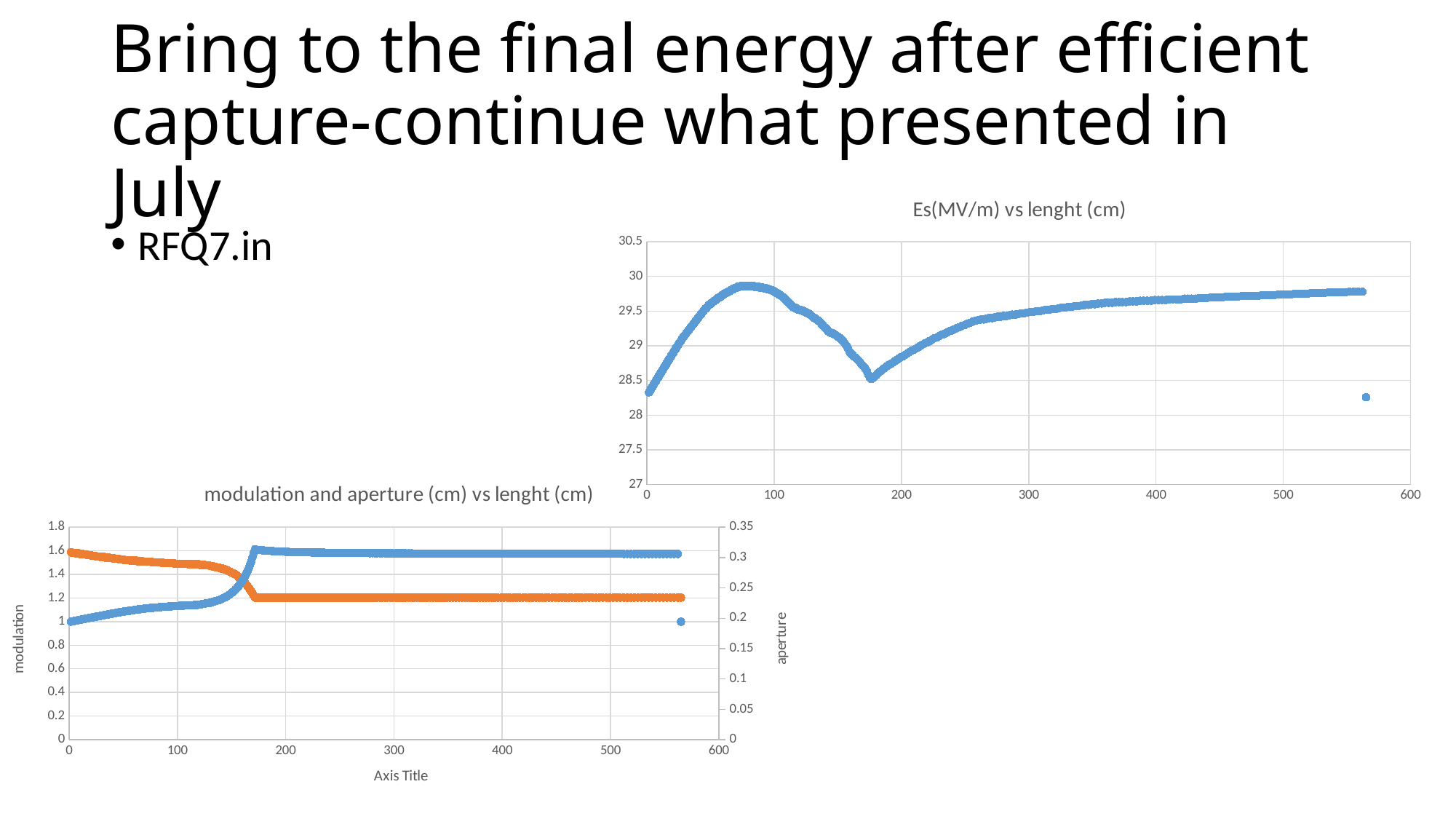
In the chart "Es(MV/m) vs lenght (cm)", does the value rise or fall between length 100 and length 180? fall In the chart "modulation and aperture (cm) vs lenght (cm)", does the orange aperture series rise or fall between length 0 and length 170? fall What kind of chart is the chart titled "modulation and aperture (cm) vs lenght (cm)"? scatter chart What kind of chart is the chart titled "Es(MV/m) vs lenght (cm)"? scatter chart In the chart "Es(MV/m) vs lenght (cm)", is the value at length 0 greater or less than 28.5? less In the chart "Es(MV/m) vs lenght (cm)", is the isolated point near length 565 greater or less than 28.5? less In the chart "modulation and aperture (cm) vs lenght (cm)", what is the label on the right-hand vertical axis? aperture In the chart "Es(MV/m) vs lenght (cm)", is the peak value near length 80 greater or less than 30? less In the chart "modulation and aperture (cm) vs lenght (cm)", what is the label shown on the horizontal axis? Axis Title